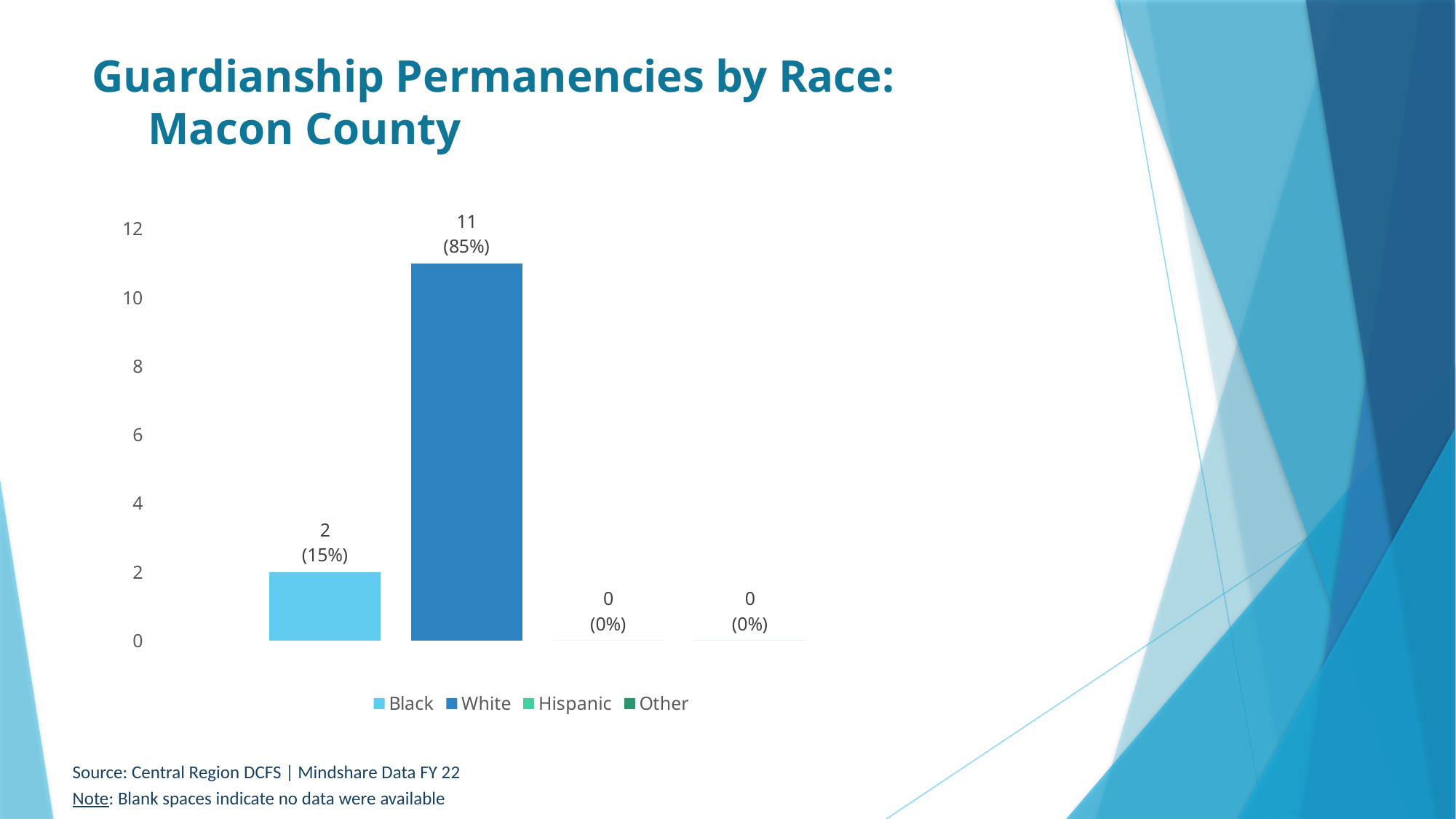
Which category has the highest value? White Is the value for White greater or less than 10? greater What kind of chart is shown on the slide? bar chart How many categories does the legend list? 4 What is the value for Black? 2 What percentage is shown for White? 85% What is the title of the slide? Guardianship Permanencies by Race: Macon County What is the difference between the values for White and Black? 9 Which is larger, the value for Black or the value for White? White What is the value for White? 11 What is the value for Hispanic? 0 What percentage is shown for Black? 15%